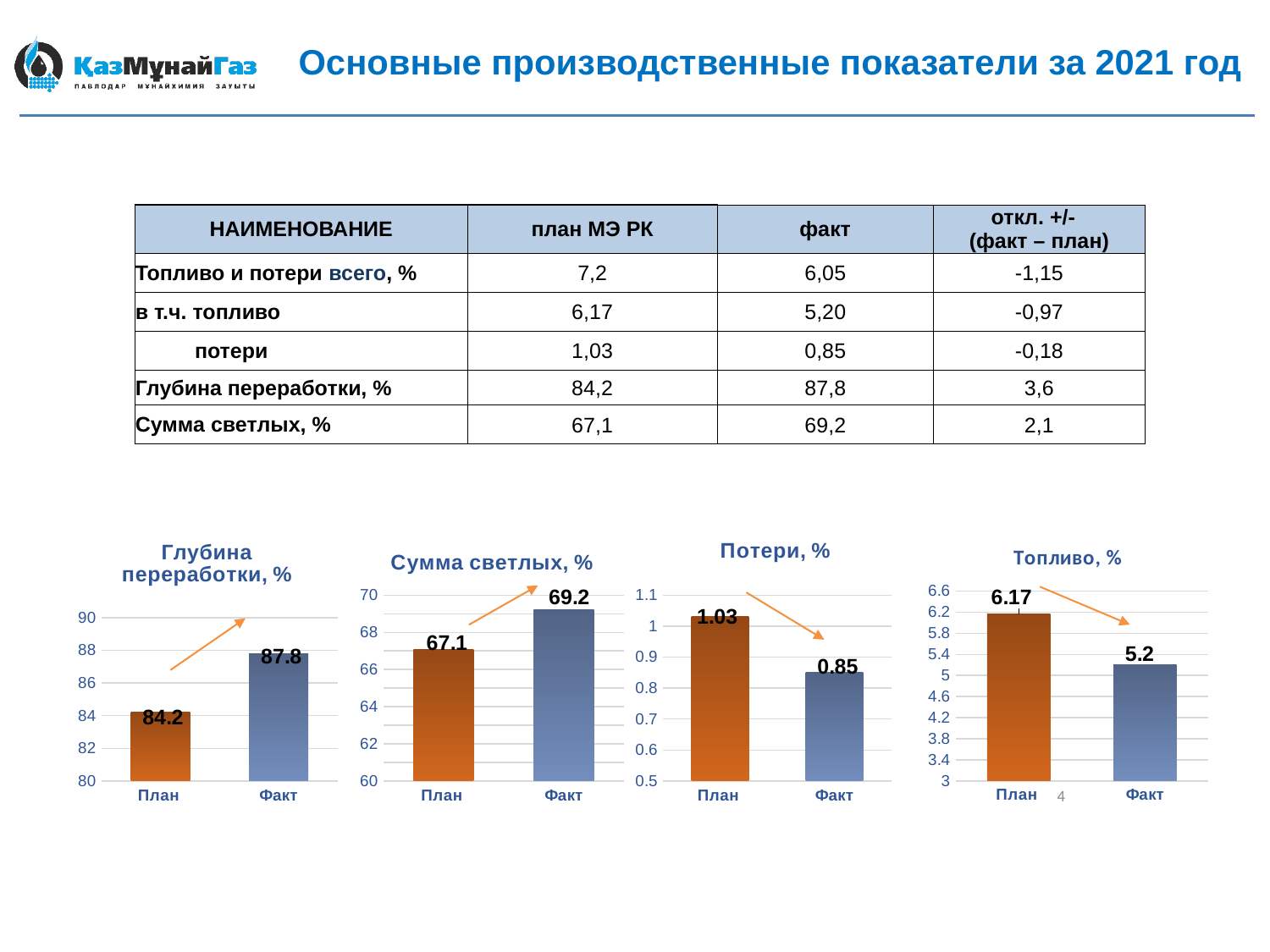
In the chart titled "Сумма светлых, %", what is the value for Факт? 69.2 In the chart titled "Топливо, %", what is the value for Факт? 5.2 In the chart titled "Топливо, %", is the value for План greater or less than 6? greater In the chart titled "Глубина переработки, %", what is the value for Факт? 87.8 In the chart titled "Глубина переработки, %", what is the value for План? 84.2 In the chart titled "Потери, %", what is the value for План? 1.03 In the chart titled "Топливо, %", what is the difference between План and Факт? 0.97 In the chart titled "Глубина переработки, %", do the values rise or fall from План to Факт? rise What type of chart is the chart titled "Сумма светлых, %"? bar chart In the chart titled "Сумма светлых, %", what is the difference between Факт and План? 2.1 In the chart titled "Потери, %", which bar is lower, План or Факт? Факт How many bars are shown in the chart titled "Потери, %"? 2